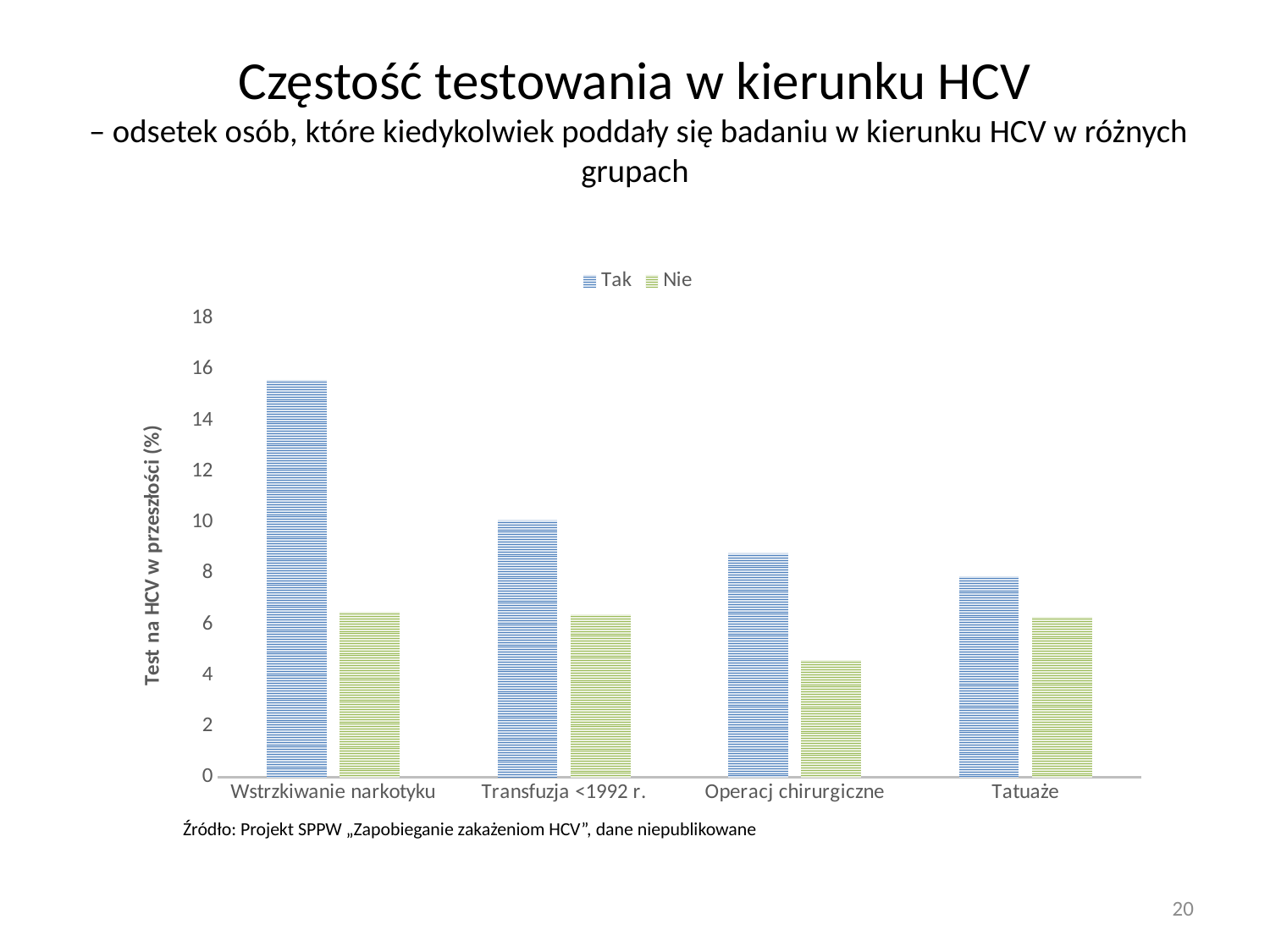
Which is larger: the Tak value for Transfuzja <1992 r. or the Tak value for Operacj chirurgiczne? Transfuzja <1992 r. What kind of chart is shown on the slide? bar chart Which category has the highest value for the Tak series? Wstrzkiwanie narkotyku Is the Tak value for Wstrzykiwanie narkotyku greater or less than 14? greater Which category has the lowest value for the Tak series? Tatuaże How many series does the legend list? 2 What is the title of the vertical axis? Test na HCV w przeszłości (%) For Transfuzja <1992 r., which series has the larger value, Tak or Nie? Tak Is the Tak value for Tatuaże greater or less than 10? less Is the Nie value for Operacj chirurgiczne greater or less than 6? less Which category has the lowest value for the Nie series? Operacj chirurgiczne How many categories are shown on the x axis? 4